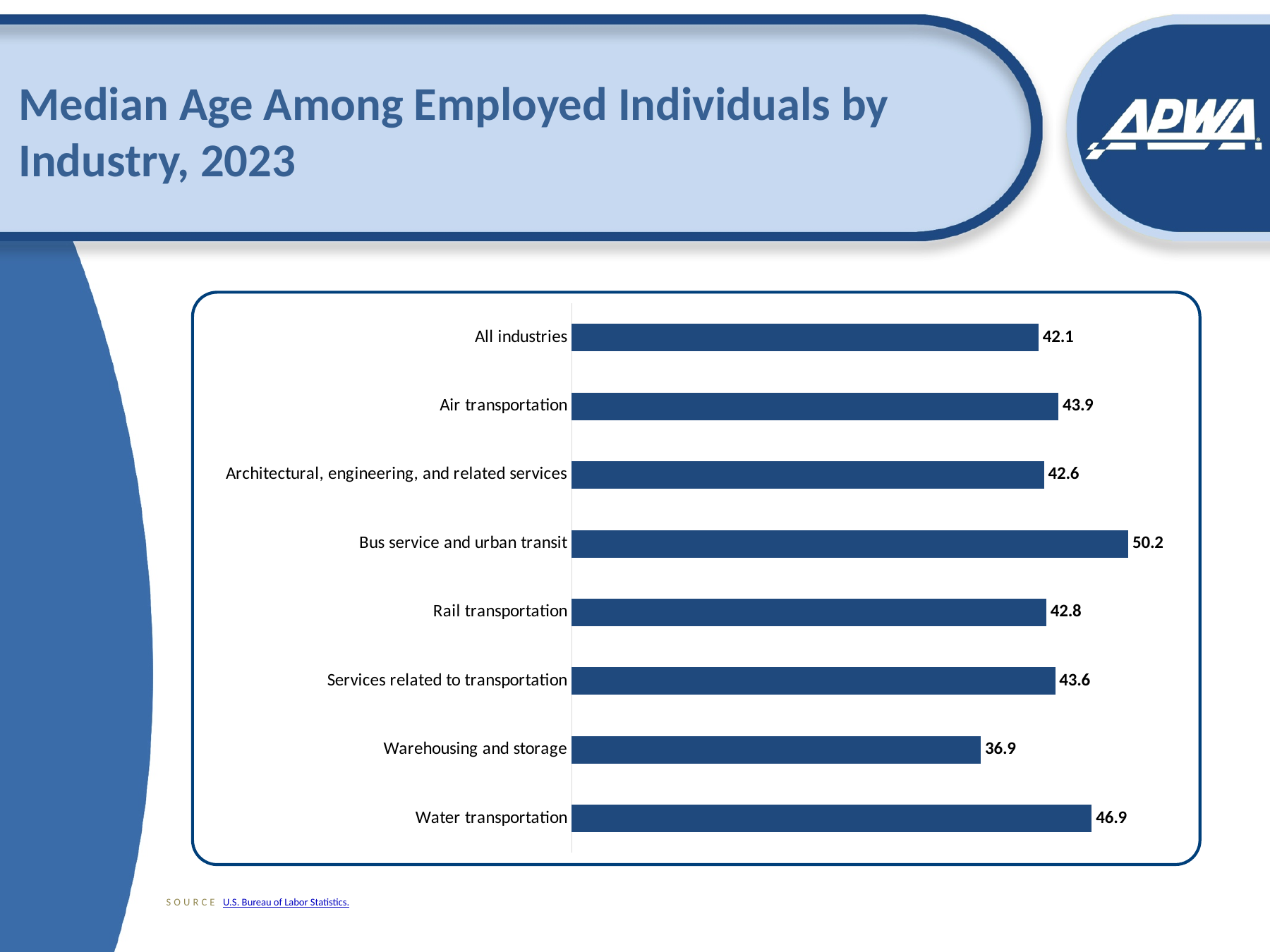
What is the median age for Water transportation? 46.9 What is the difference in median age between Water transportation and All industries? 4.8 Which industry has the highest median age? Bus service and urban transit What is the median age for Warehousing and storage? 36.9 What is the difference in median age between Bus service and urban transit and Warehousing and storage? 13.3 Which industry has the lowest median age? Warehousing and storage How many industry categories are shown in the chart? 8 What type of chart is shown on the slide? Bar chart What is the median age for Bus service and urban transit? 50.2 Which has a higher median age, Air transportation or Rail transportation? Air transportation What is the median age for All industries? 42.1 What is the title of the slide? Median Age Among Employed Individuals by Industry, 2023